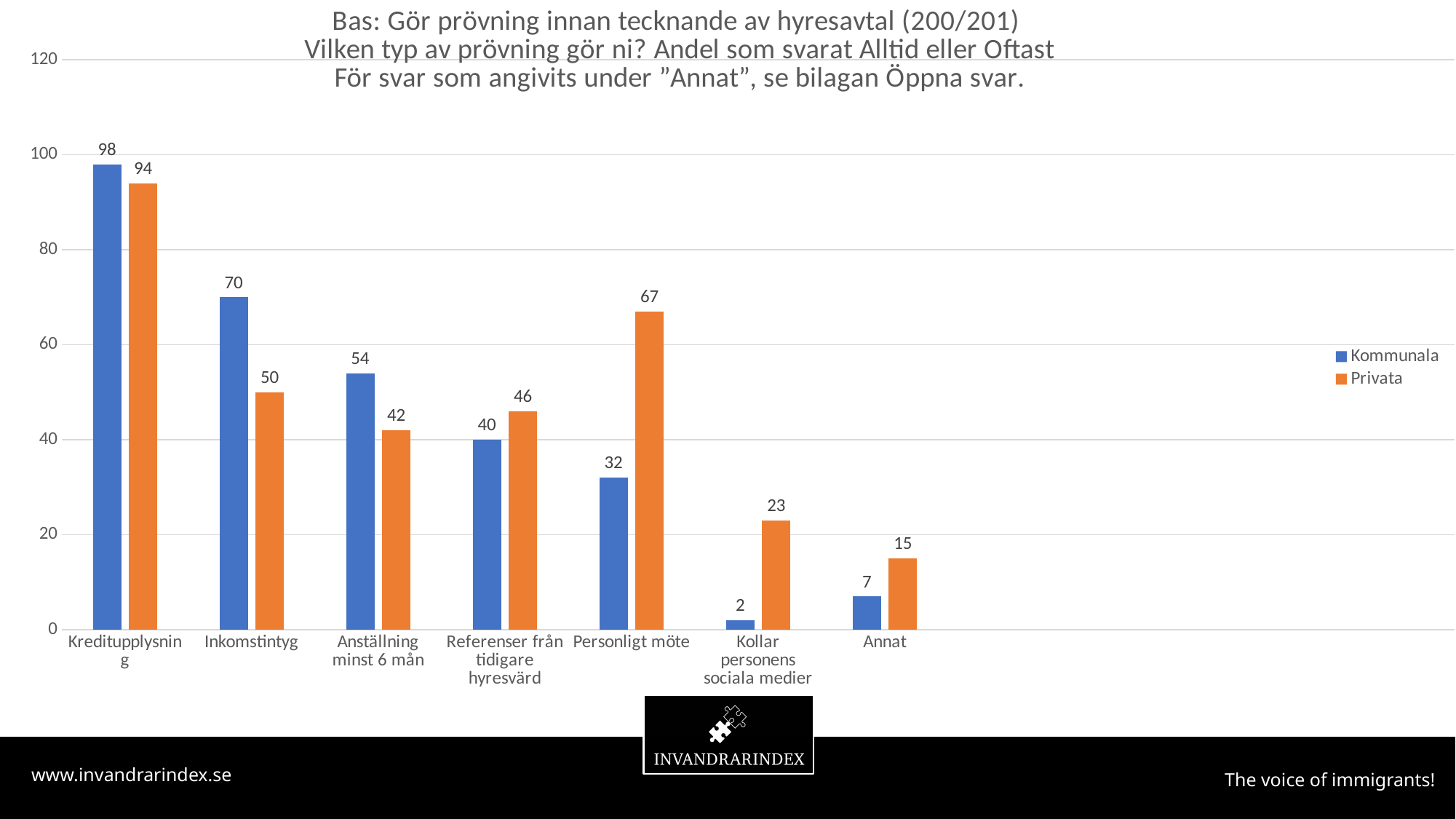
What kind of chart is shown on the slide? Bar chart How many series does the legend list? 2 How many categories are shown on the x axis? 7 Which category has the highest Privata value? Kreditupplysning Which category has the lowest Kommunala value? Kollar personens sociala medier What is the difference between the Kommunala and Privata values for Inkomstintyg? 20 For Personligt möte, which series has the larger value, Kommunala or Privata? Privata What is the Kommunala value for Kreditupplysning? 98 What is the Privata value for Personligt möte? 67 Which colour represents the Privata series? Orange Is the Privata value for Anställning minst 6 mån greater or less than 40? greater What is the Kommunala value for Kollar personens sociala medier? 2